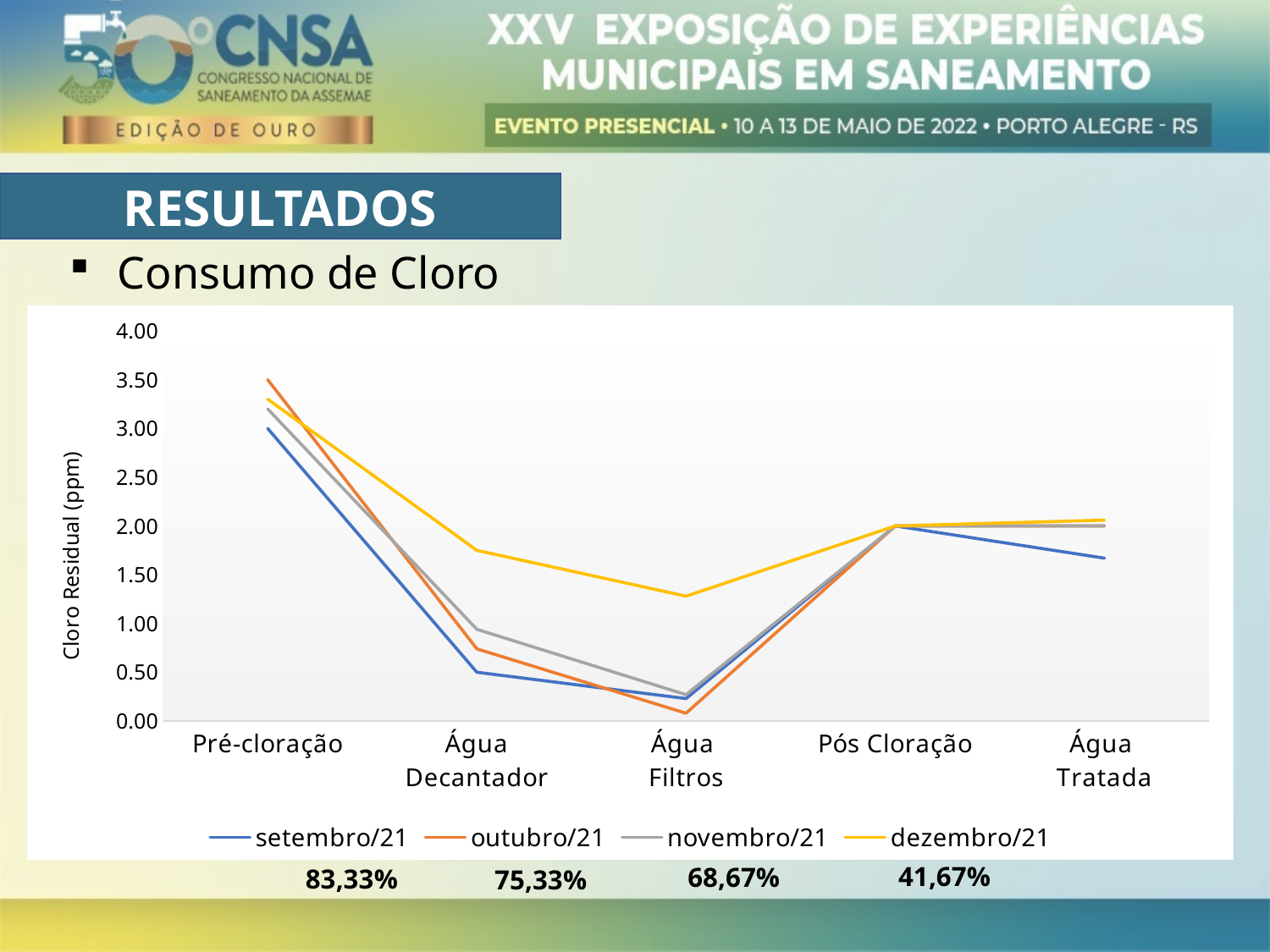
Is the value for dezembro/21 at Água Filtros greater or less than 1.00? greater Which series has the lowest value at Água Filtros? outubro/21 Is the value for setembro/21 at Água Tratada greater or less than 2.00? less Does the setembro/21 line rise or fall from Pré-cloração to Água Filtros? fall Which series has the highest value at Água Filtros? dezembro/21 Which series has the lowest value at Água Decantador? setembro/21 How many series does the legend list? 4 What is the y-axis title of the chart? Cloro Residual (ppm) Which series has the highest value at Pré-cloração? outubro/21 How many categories are shown on the x axis? 5 Is the value for outubro/21 at Água Filtros greater or less than 0.50? less What kind of chart is shown on the slide? line chart